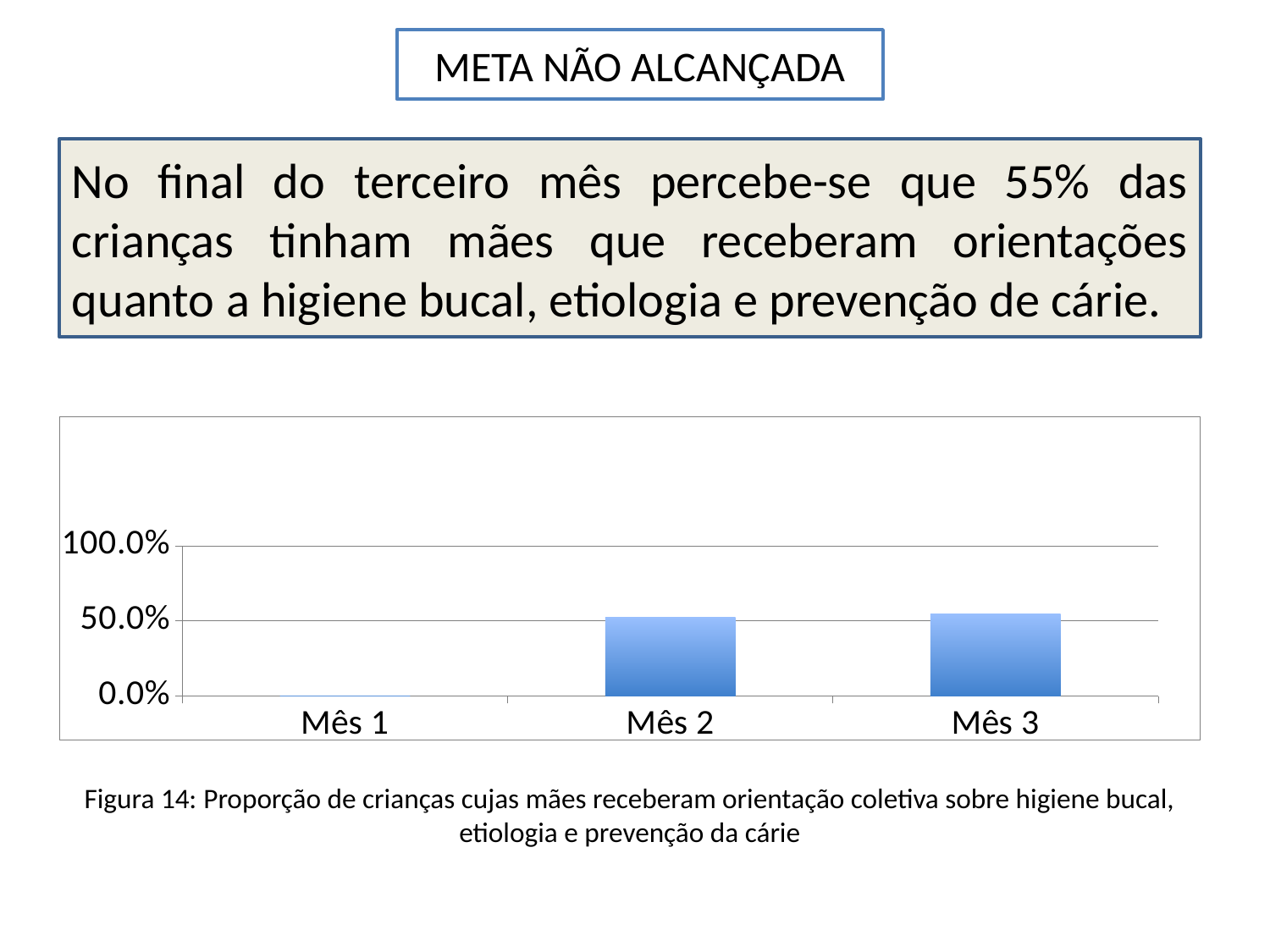
Is the value for Mês 2 greater or less than 100.0%? less Is the value for Mês 1 greater or less than 50.0%? less Which month has the highest bar in the chart? Mês 3 Which has the larger value, Mês 1 or Mês 2? Mês 2 Is the value for Mês 3 greater or less than 50.0%? greater Do the values rise or fall from Mês 1 to Mês 3? rise How many categories are shown on the x axis of the chart? 3 What figure number is given in the caption below the chart? Figura 14 What kind of chart is shown on the slide? bar chart What is the highest tick value shown on the y axis of the chart? 100.0% Which month has the lowest bar in the chart? Mês 1